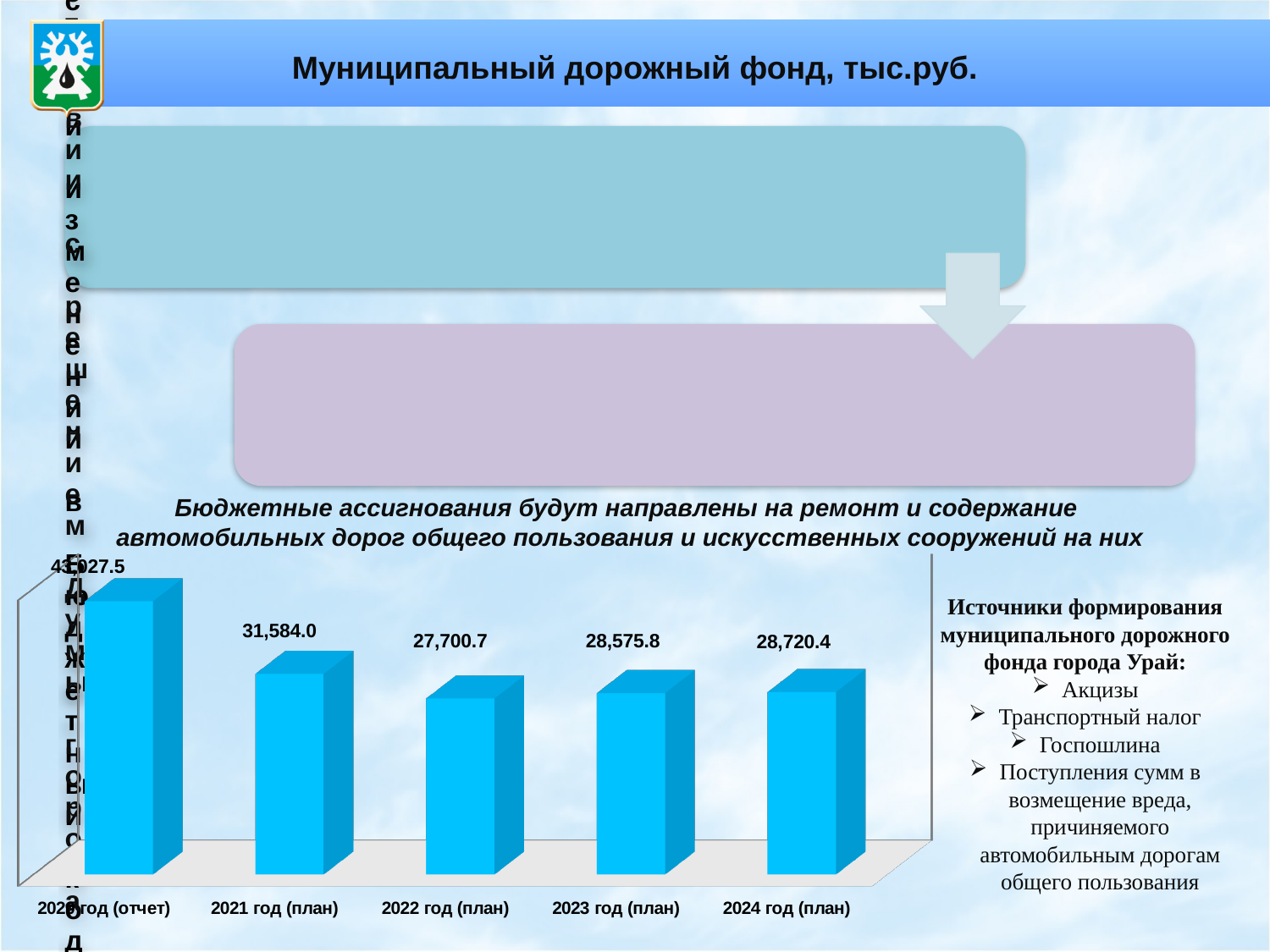
What is the value for 2021 год (план)? 31,584.0 Which is larger, the value for 2023 год (план) or 2024 год (план)? 2024 год (план) How many bars (years) are plotted in the chart? 5 What is the difference between the values for 2021 год (план) and 2022 год (план)? 3,883.3 What is the value for 2023 год (план)? 28,575.8 What type of chart is shown on the slide? Bar chart What is the value for 2024 год (план)? 28,720.4 Which year has the highest value in the chart? 2020 год (отчет) What is the title of the slide above the chart? Муниципальный дорожный фонд, тыс.руб. Which year has the lowest value in the chart? 2022 год (план) What is the value for 2022 год (план)? 27,700.7 What is the difference between the values for 2024 год (план) and 2023 год (план)? 144.6